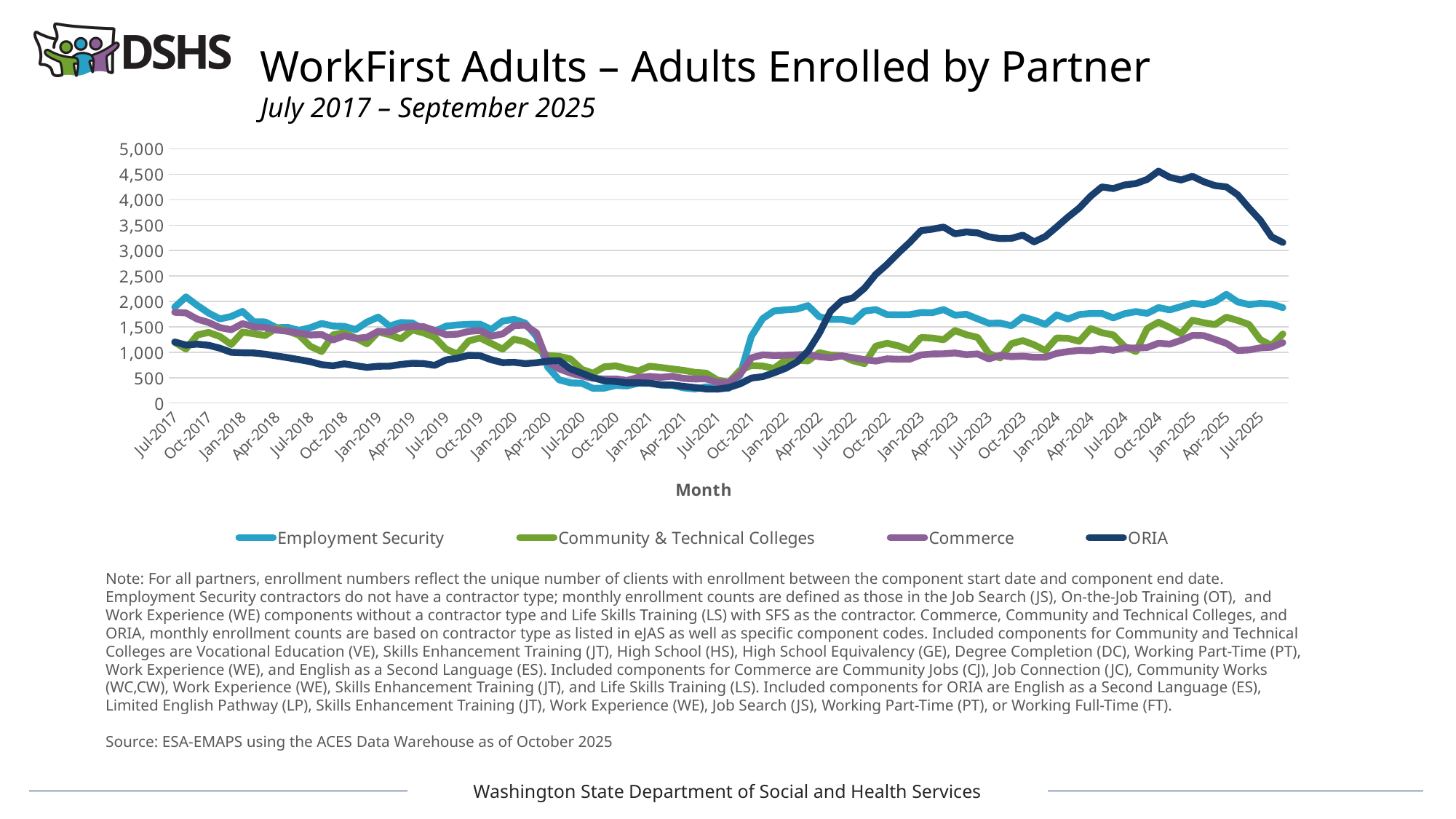
In Jan-2023, which is larger: ORIA or Employment Security? ORIA Is the value for ORIA in Jul-2021 greater or less than 500? less Is the value for ORIA in Oct-2024 greater or less than 4,000? greater In Jul-2018, which is larger: Employment Security or ORIA? Employment Security How many series does the legend list? 4 Does the ORIA line rise or fall between Oct-2024 and Jul-2025? fall Is the value for Commerce in Jan-2022 greater or less than 1,500? less Which series reaches the highest value anywhere on the chart? ORIA Which partners are listed in the chart legend? Employment Security, Community & Technical Colleges, Commerce, ORIA What kind of chart is shown on the slide? Line chart What is the title of the x axis? Month